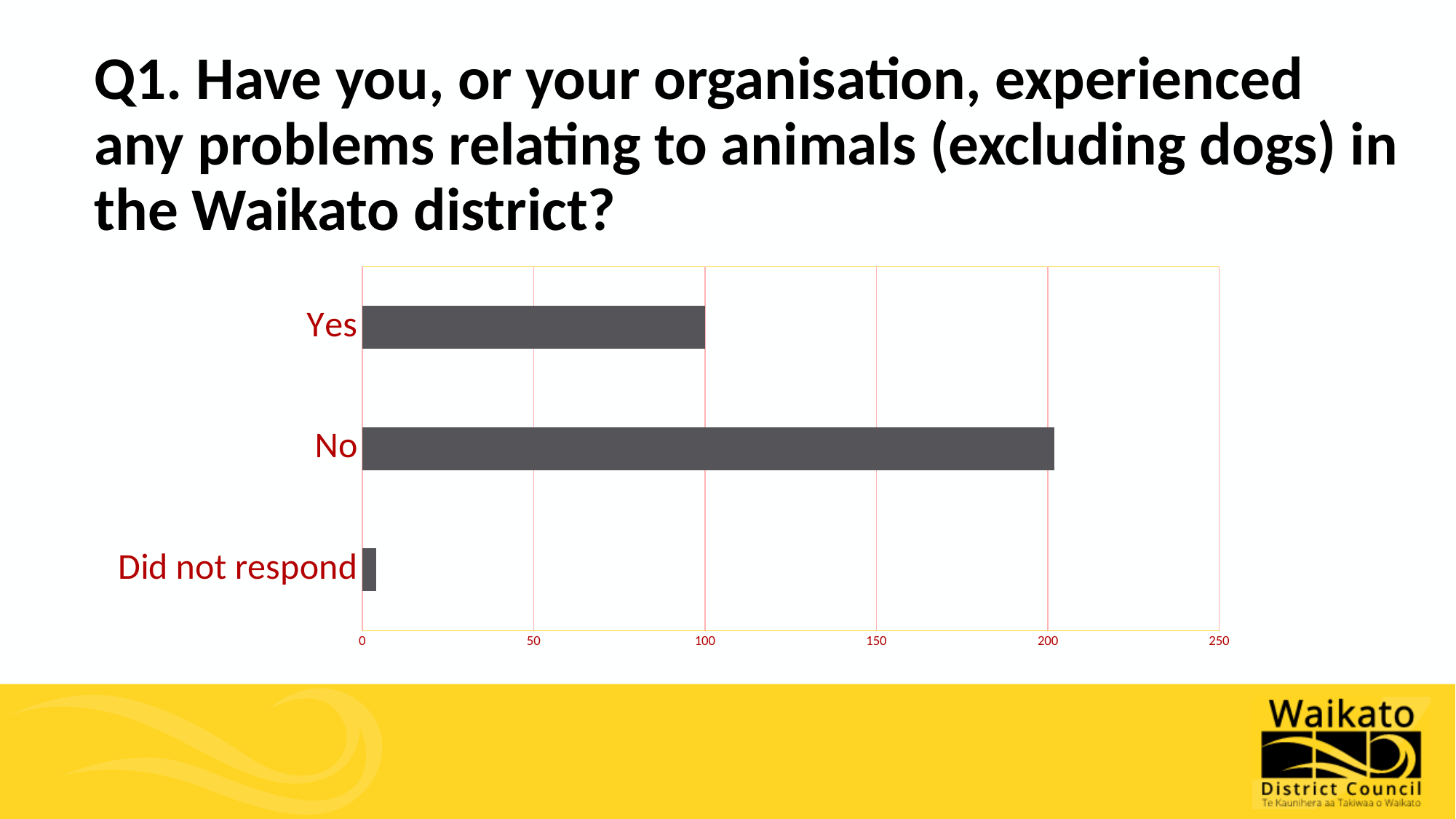
Is the value for Did not respond greater or less than 50? less Which category has the highest value? No What is the highest value shown on the horizontal axis? 250 What kind of chart is shown on the slide? bar chart How many categories are shown in the chart? 3 Is the value for Yes greater or less than 50? greater Which is larger, the value for Yes or the value for No? No Is the value for Yes greater or less than 150? less Which is larger, the value for Yes or the value for Did not respond? Yes Which category has the lowest value? Did not respond What are the three category labels on the vertical axis, from top to bottom? Yes, No, Did not respond